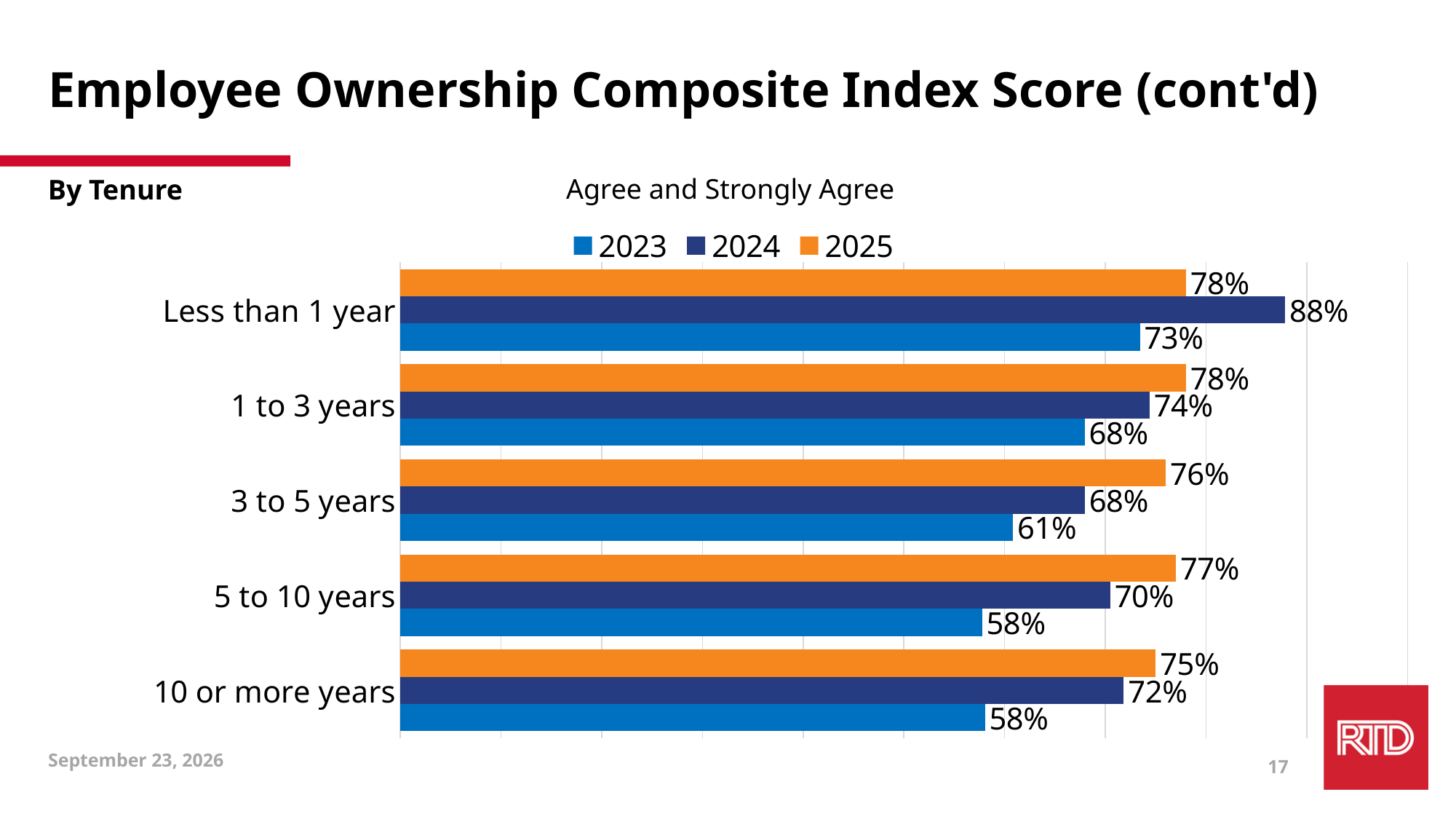
What kind of chart is shown on the slide? Bar chart What is the 2025 value for 3 to 5 years? 76% What is the difference between the 2025 and 2023 values for 5 to 10 years? 19% What is the subtitle shown above the chart legend? Agree and Strongly Agree For 3 to 5 years, do the values rise or fall from 2023 to 2025? Rise Which tenure category has the lowest 2025 value? 10 or more years What is the 2024 value for Less than 1 year? 88% What is the 2023 value for 5 to 10 years? 58% Which is larger for 1 to 3 years: the 2024 value or the 2023 value? 2024 How many tenure categories are shown on the chart? 5 Which tenure category has the highest 2024 value? Less than 1 year How many series does the legend list? 3